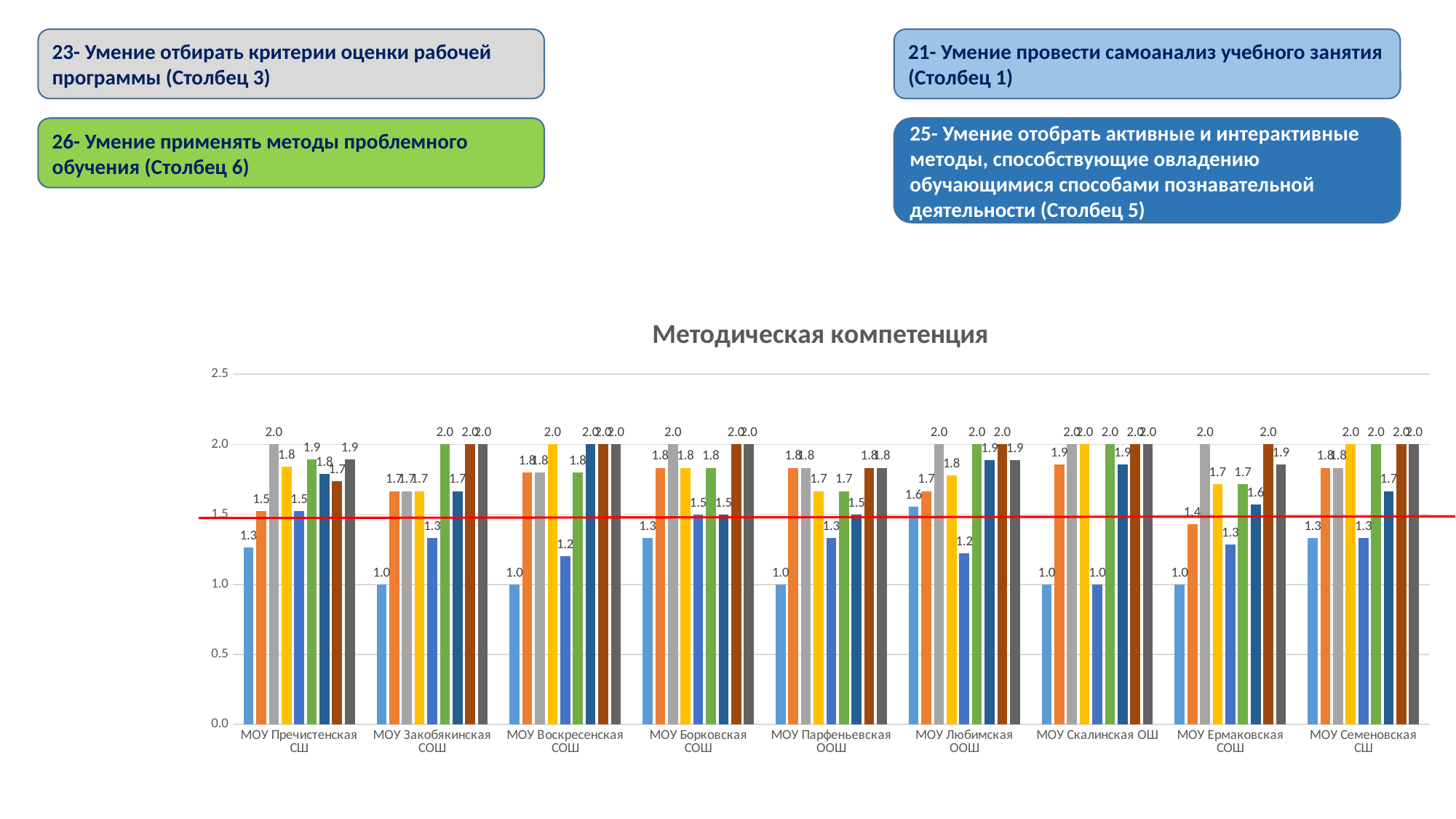
Which school has the highest value for the first (light blue) bar? МОУ Любимская ООШ At what value on the y axis is the red horizontal line drawn across the chart? 1.5 What is the value of the second (orange) bar for МОУ Ермаковская СОШ? 1.4 Is the value of the third (gray) bar for МОУ Пречистенская СШ greater or less than 1.5? greater What type of chart is shown on the slide? bar chart What is the value of the first (light blue) bar for МОУ Любимская ООШ? 1.6 What is the title of the chart? Методическая компетенция Is the value of the first (light blue) bar for МОУ Скалинская ОШ greater or less than 1.5? less How many schools (categories) are shown on the x axis of the chart? 9 Which school has the larger value for the second (orange) bar: МОУ Скалинская ОШ or МОУ Ермаковская СОШ? МОУ Скалинская ОШ What is the value of the first (light blue) bar for МОУ Пречистенская СШ? 1.3 For МОУ Пречистенская СШ, what is the difference between the third (gray) bar and the first (light blue) bar? 0.7